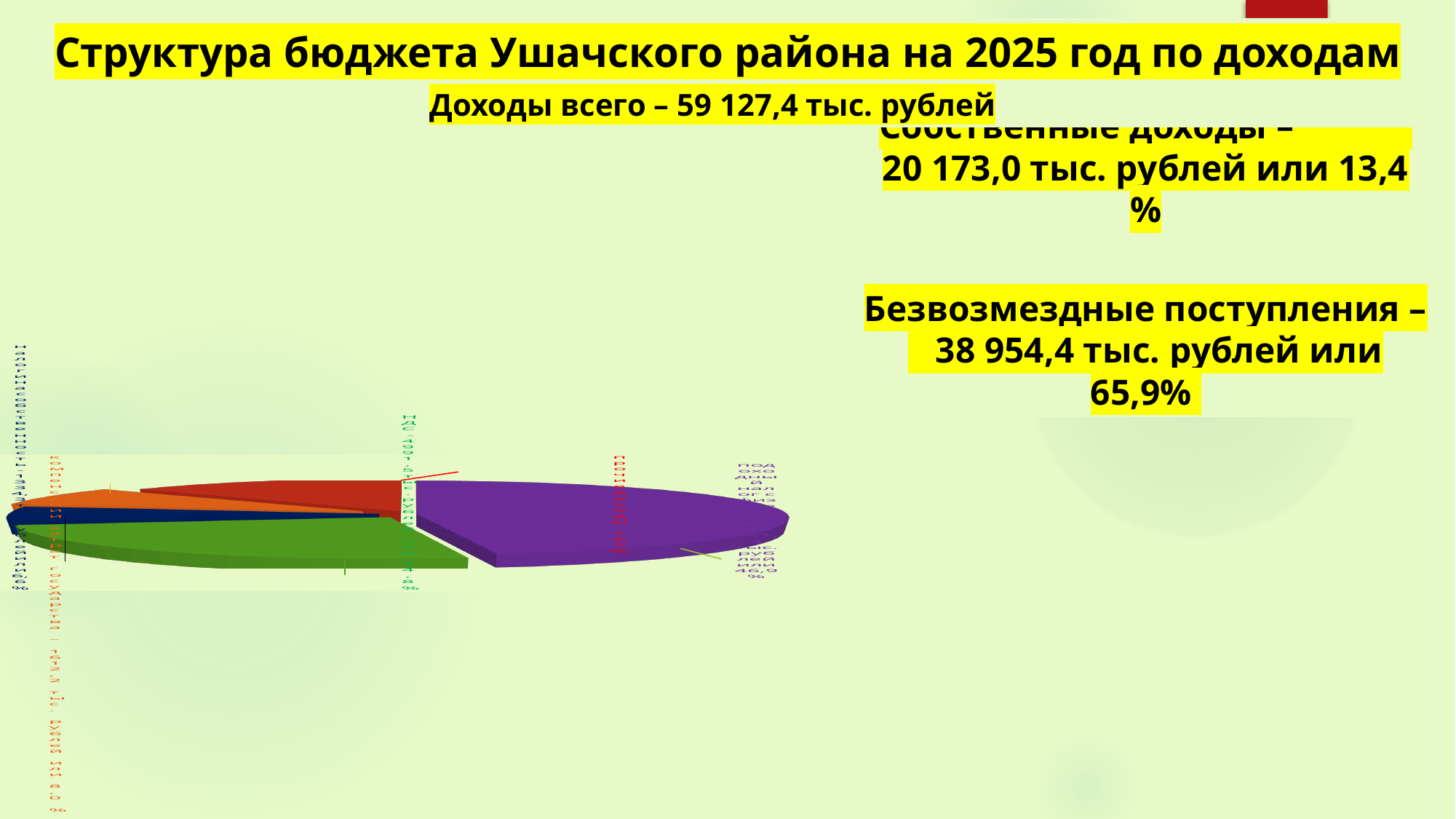
What kind of chart is shown on the slide? pie chart Which colour slice is the largest in the pie chart? purple How many slices does the pie chart have? 5 Is the purple slice of the pie chart larger or smaller than the green slice? larger